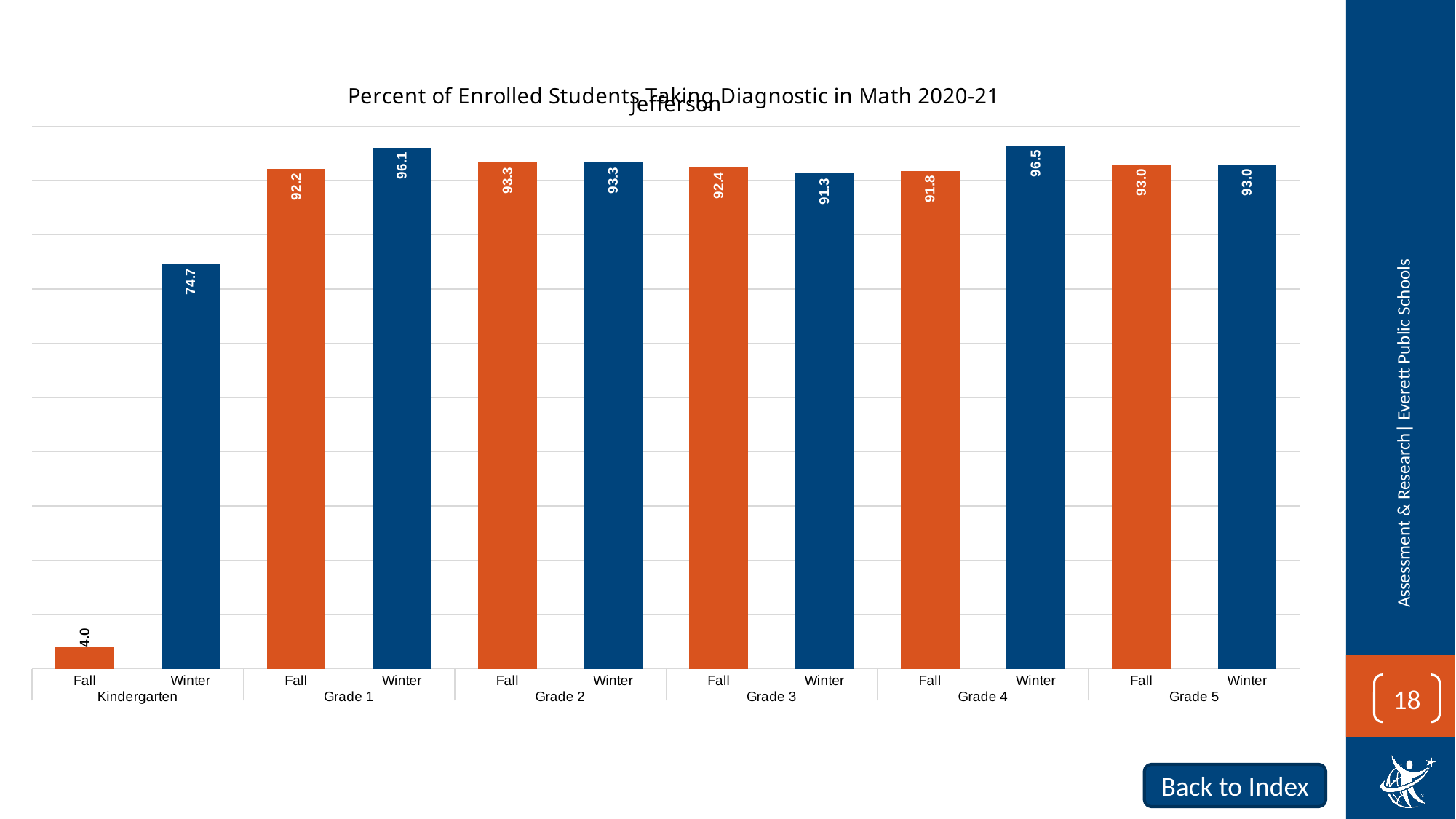
Which bar has the highest value? Grade 4 Winter What is the value for Grade 1 Winter? 96.1 Which bar has the lowest value? Kindergarten Fall What is the value for Kindergarten Fall? 4.0 What school name appears in the chart title? Jefferson What is the value for Grade 4 Winter? 96.5 What is the value for Grade 3 Fall? 92.4 Which is larger, the Grade 3 Fall value or the Grade 3 Winter value? Grade 3 Fall How many grade-level groups are shown on the x axis? 6 What is the difference between the Kindergarten Winter and Kindergarten Fall values? 70.7 What kind of chart is shown on the slide? Bar chart What is the difference between the Grade 4 Winter and Grade 4 Fall values? 4.7